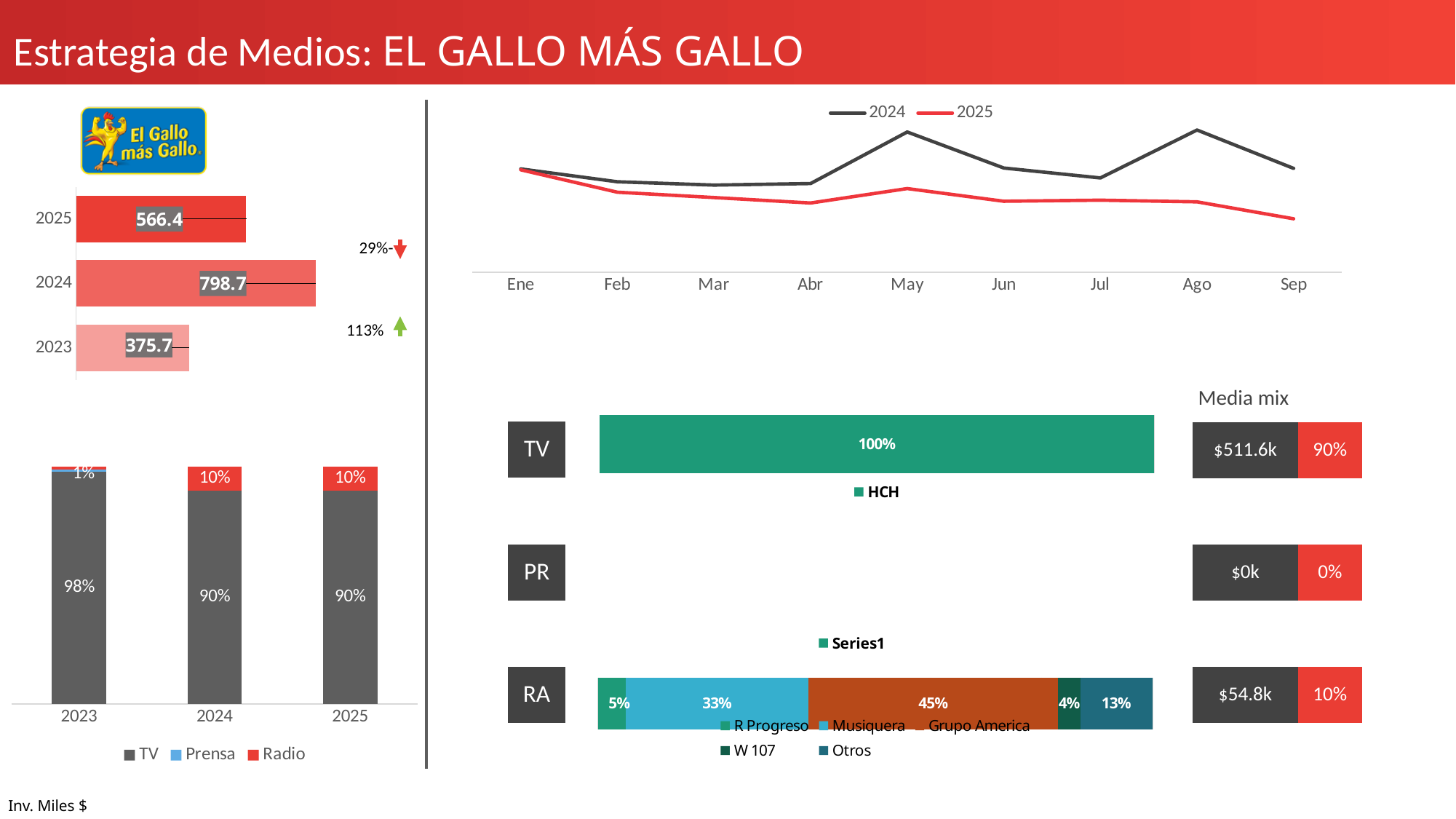
In the horizontal bar chart of yearly investment on the left, which year has the highest value? 2024 In the line chart at the top right, how many months are shown on the x axis? 9 In the horizontal bar chart of yearly investment on the left, what is the value for 2024? 798.7 In the line chart at the top right, which series is higher in May, 2024 or 2025? 2024 In the Media mix table at the bottom right, what is the investment amount for TV? $511.6k In the stacked bar chart of media share at the bottom left, what is the Radio share for 2025? 10% In the line chart at the top right, how many series does the legend list? 2 In the horizontal bar chart of yearly investment on the left, what is the difference between the 2024 and 2025 values? 232.3 In the stacked bar chart of media share at the bottom left, what is the TV share for 2023? 98% In the RA (radio) bar at the bottom right, what is the share for Grupo America? 45% In the horizontal bar chart of yearly investment on the left, which year has the lowest value? 2023 In the horizontal bar chart of yearly investment on the left, what is the value for 2023? 375.7